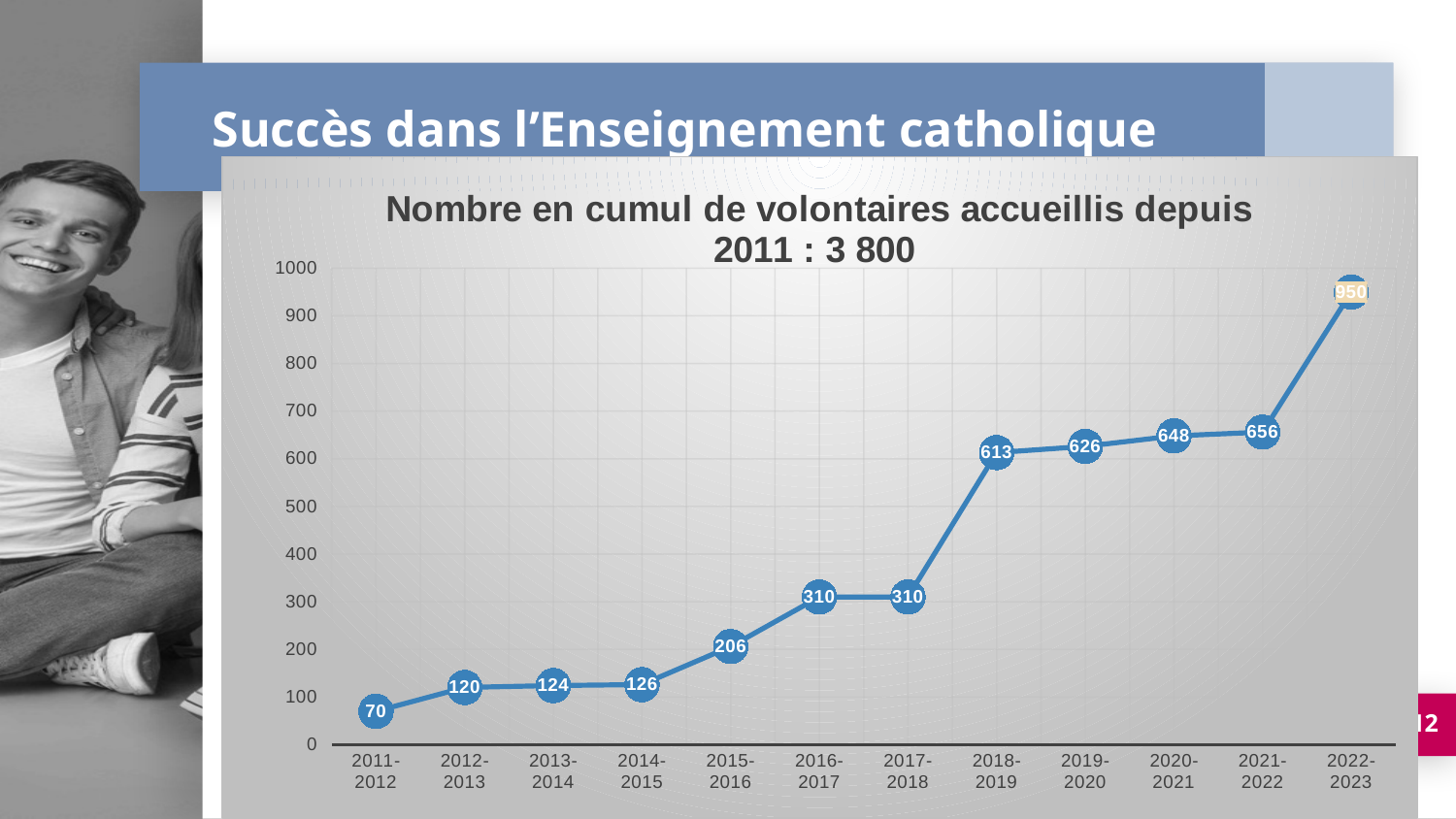
What is the value for 2022-2023? 950 How many data points are plotted on the chart? 12 What is the value for 2011-2012? 70 Which period has the highest value? 2022-2023 What type of chart is shown on the slide? line chart Which is larger, the value for 2015-2016 or the value for 2014-2015? 2015-2016 What is the value for 2018-2019? 613 What is the difference between the values for 2022-2023 and 2021-2022? 294 What is the title of the chart? Nombre en cumul de volontaires accueillis depuis 2011 : 3 800 Do the values generally rise or fall from 2011-2012 to 2022-2023? rise Which period has the lowest value? 2011-2012 What is the difference between the values for 2018-2019 and 2017-2018? 303